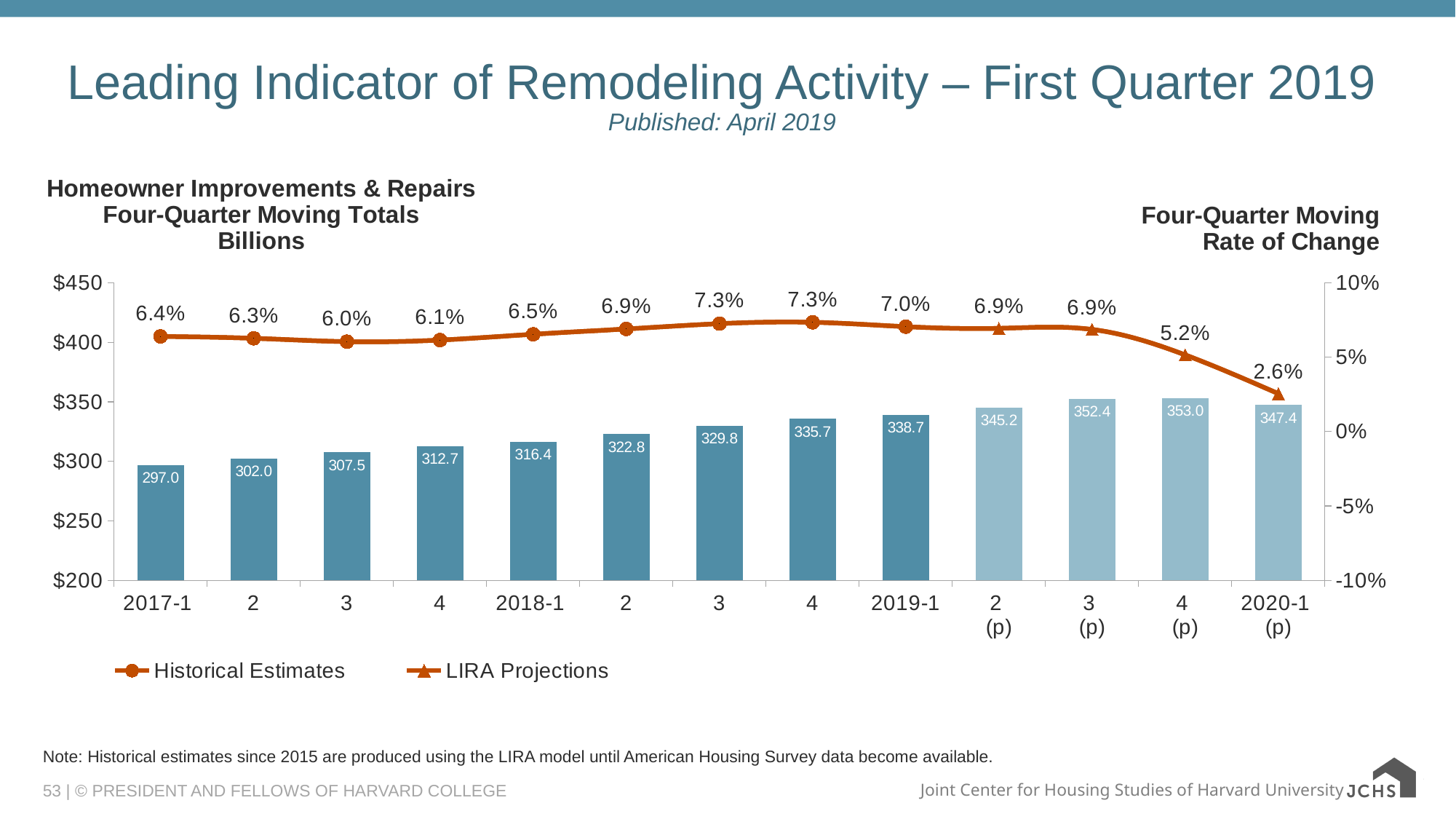
Which quarter has the highest four-quarter moving total bar? 4 (p) of 2019 What is the four-quarter moving rate of change shown for 2018-3? 7.3% What is the difference between the four-quarter moving total for 2019-4 (p) and for 2017-1? 56.0 What is the four-quarter moving total for homeowner improvements and repairs in 2019-1? 338.7 Which is larger, the four-quarter moving total for 2018-2 or for 2019-2 (p)? 2019-2 (p) What is the projected four-quarter moving rate of change for 2020-1 (p)? 2.6% Which quarter has the lowest four-quarter moving total bar? 2017-1 Which quarter has the lowest four-quarter moving rate of change? 2020-1 (p) Does the four-quarter moving rate of change rise or fall from 2019-1 to 2020-1 (p)? Fall How many quarters are plotted on the x axis? 13 What kind of chart is used to show the four-quarter moving totals in billions? Bar chart How many series does the legend list? 2